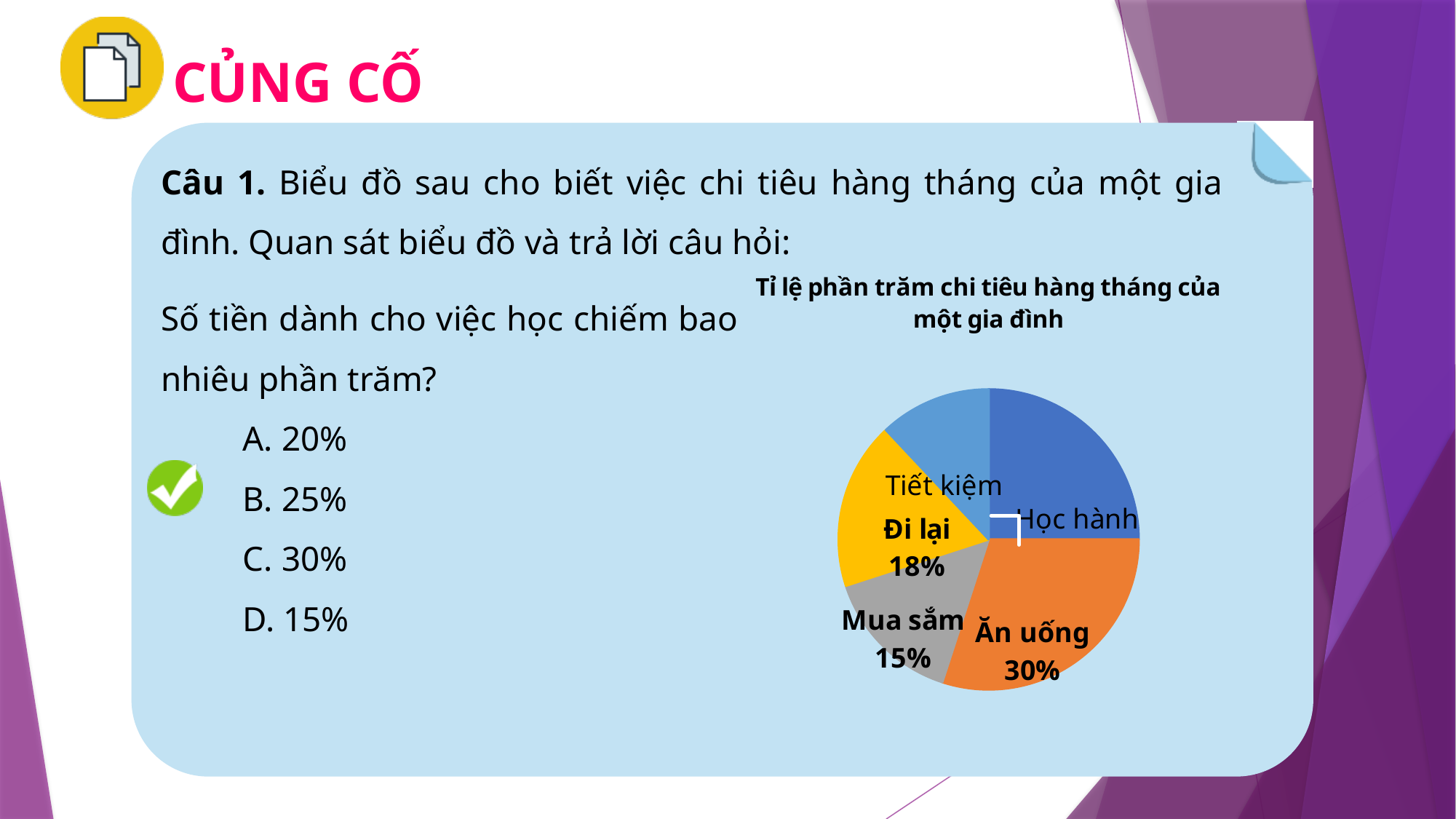
What colour is the Ăn uống slice in the pie chart? orange What percentage is shown for Mua sắm in the pie chart? 15% What is the difference between the percentages for Đi lại and Mua sắm? 3% What is the difference between the percentages for Ăn uống and Mua sắm? 15% What is the title of the pie chart? Tỉ lệ phần trăm chi tiêu hàng tháng của một gia đình Which is larger in the pie chart, Đi lại or Mua sắm? Đi lại What percentage is shown for Đi lại in the pie chart? 18% What percentage is shown for Ăn uống in the pie chart? 30% How many slices does the pie chart have? 5 Which is larger in the pie chart, Ăn uống or Mua sắm? Ăn uống Which category has the largest slice in the pie chart? Ăn uống What kind of chart is shown on the slide? pie chart